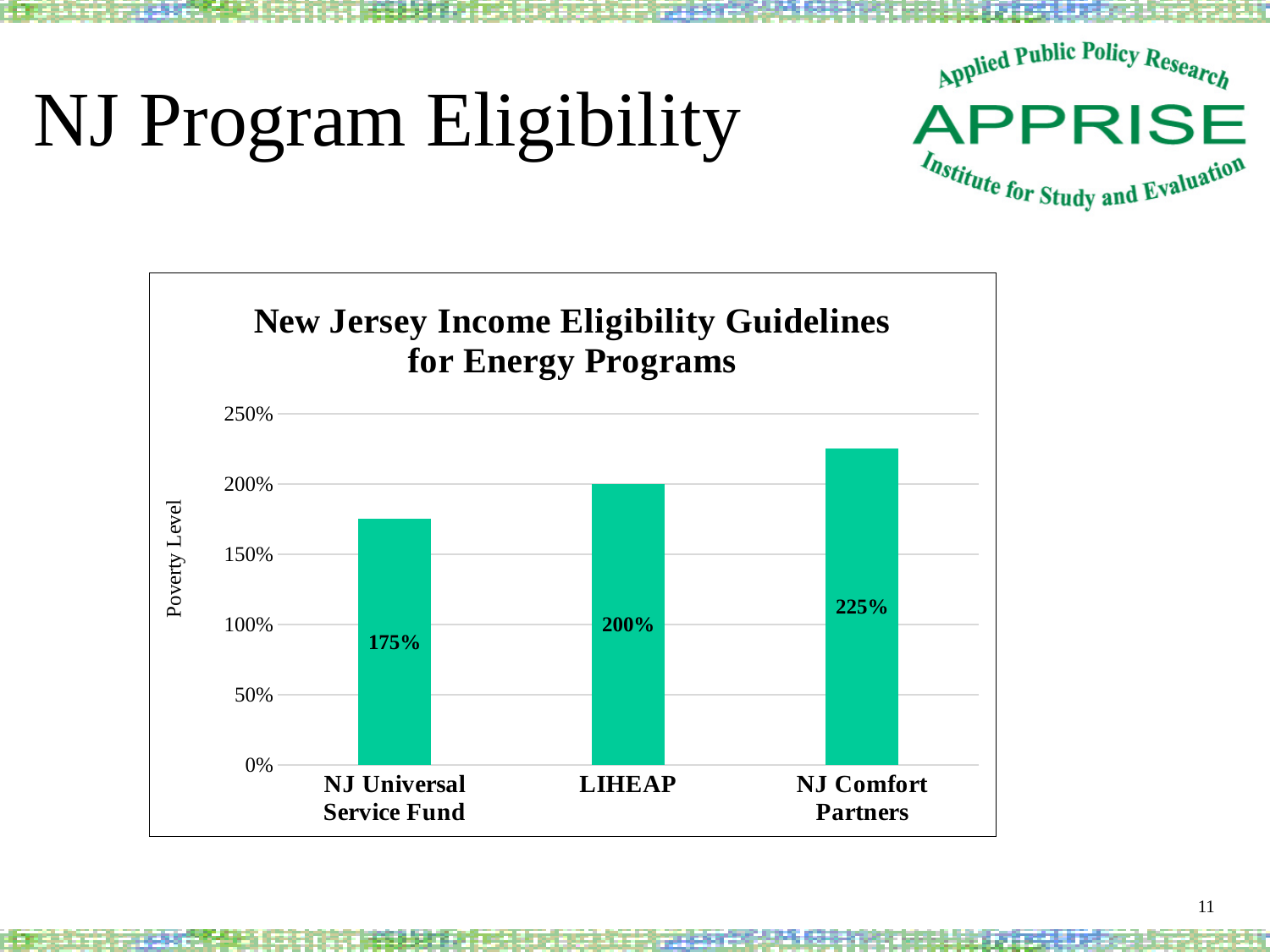
What is the difference between the eligibility guidelines for NJ Comfort Partners and the NJ Universal Service Fund? 50% How many programs are shown in the chart? 3 What type of chart is shown on the slide? Bar chart What is the poverty level eligibility guideline for the NJ Universal Service Fund? 175% Which program has the highest income eligibility guideline? NJ Comfort Partners Is the value for the NJ Universal Service Fund greater or less than 200%? less What is the poverty level eligibility guideline for NJ Comfort Partners? 225% What is the title of the chart? New Jersey Income Eligibility Guidelines for Energy Programs Which program has the lowest income eligibility guideline? NJ Universal Service Fund Which has a higher eligibility guideline, LIHEAP or NJ Comfort Partners? NJ Comfort Partners What is the difference between the eligibility guidelines for LIHEAP and the NJ Universal Service Fund? 25% What is the poverty level eligibility guideline for LIHEAP? 200%